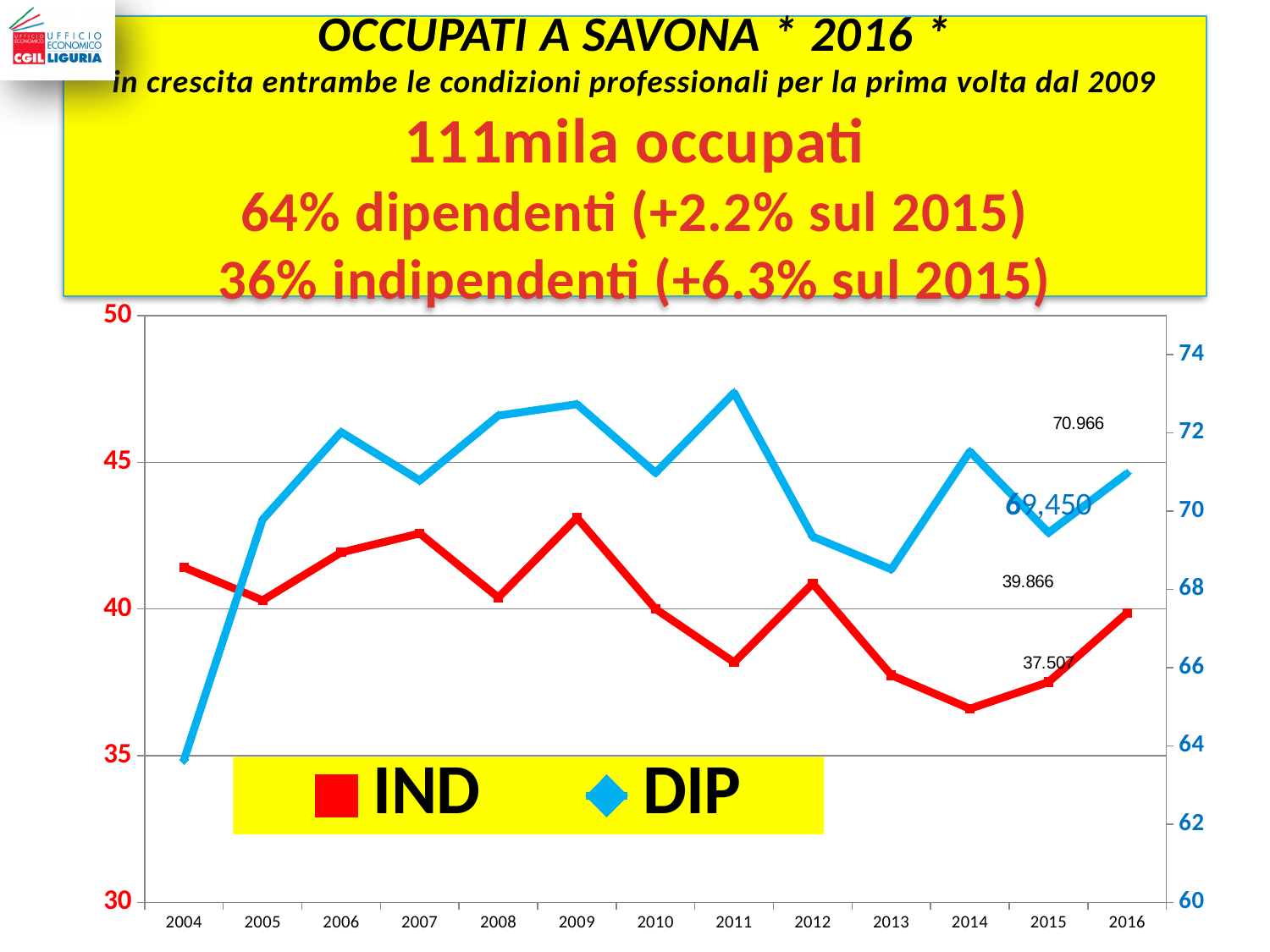
How many years are plotted along the x axis? 13 In which year is the IND series at its lowest? 2014 What are the two series named in the legend? IND and DIP Is the DIP value for 2013 greater or less than 70? less Does the IND series rise or fall from 2012 to 2014? fall In which year is the DIP series at its lowest? 2004 What colour is the DIP line? blue Which year has the higher IND value, 2012 or 2013? 2012 In which year is the IND series at its highest? 2009 What kind of chart is shown on the slide? line chart How many series does the legend list? 2 Is the IND value for 2004 greater or less than 40? greater